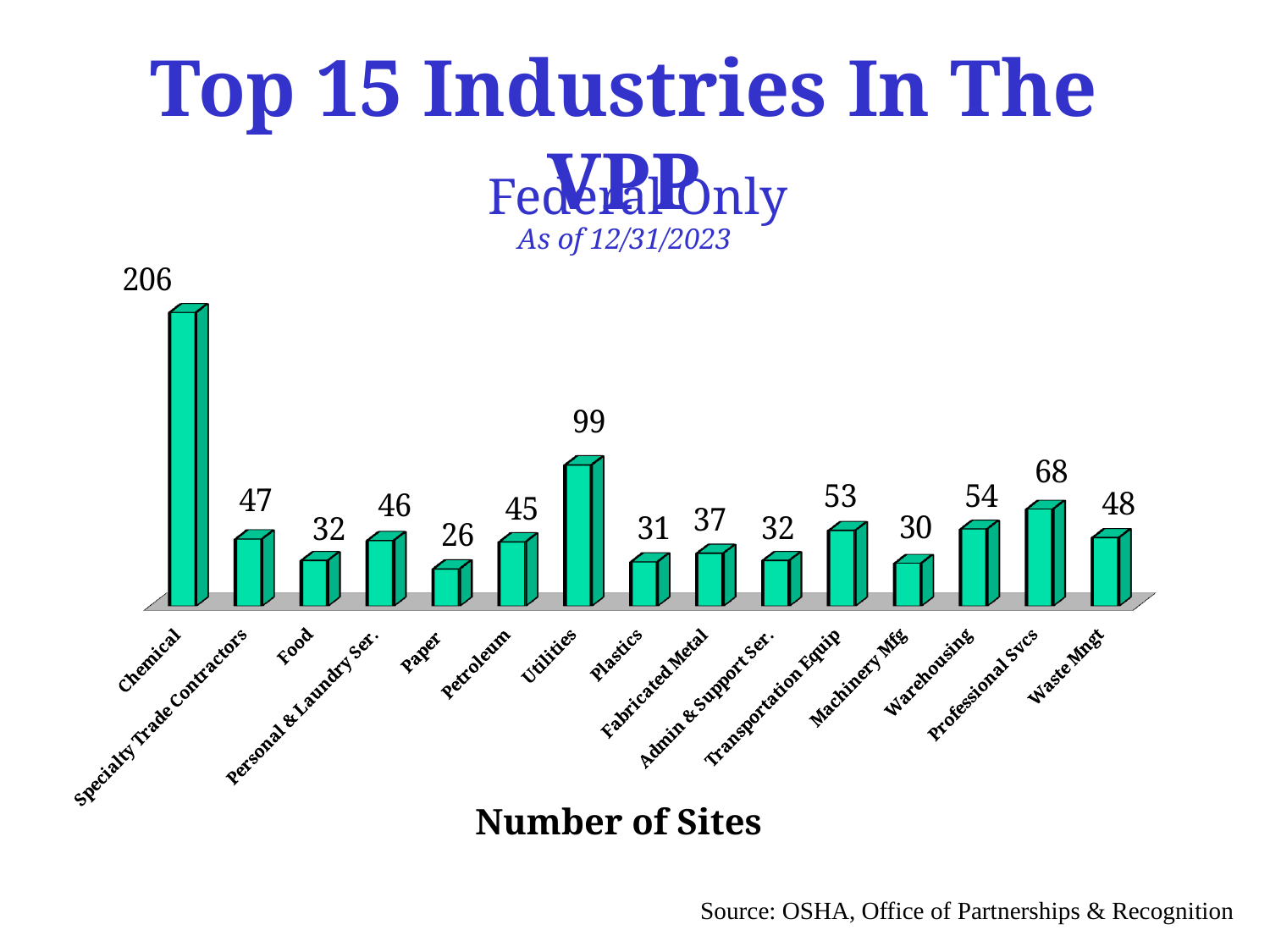
What is the label on the horizontal axis of the chart? Number of Sites How many industries are shown in the chart? 15 What is the number of sites for Utilities? 99 What is the difference in number of sites between Chemical and Utilities? 107 Which industry has the highest number of sites? Chemical What is the difference in number of sites between Warehousing and Transportation Equip? 1 What type of chart is shown on the slide? Bar chart What is the number of sites for Paper? 26 What is the number of sites for Professional Svcs? 68 Which has more sites, Specialty Trade Contractors or Waste Mngt? Waste Mngt What is the number of sites for Chemical? 206 Which industry has the lowest number of sites? Paper